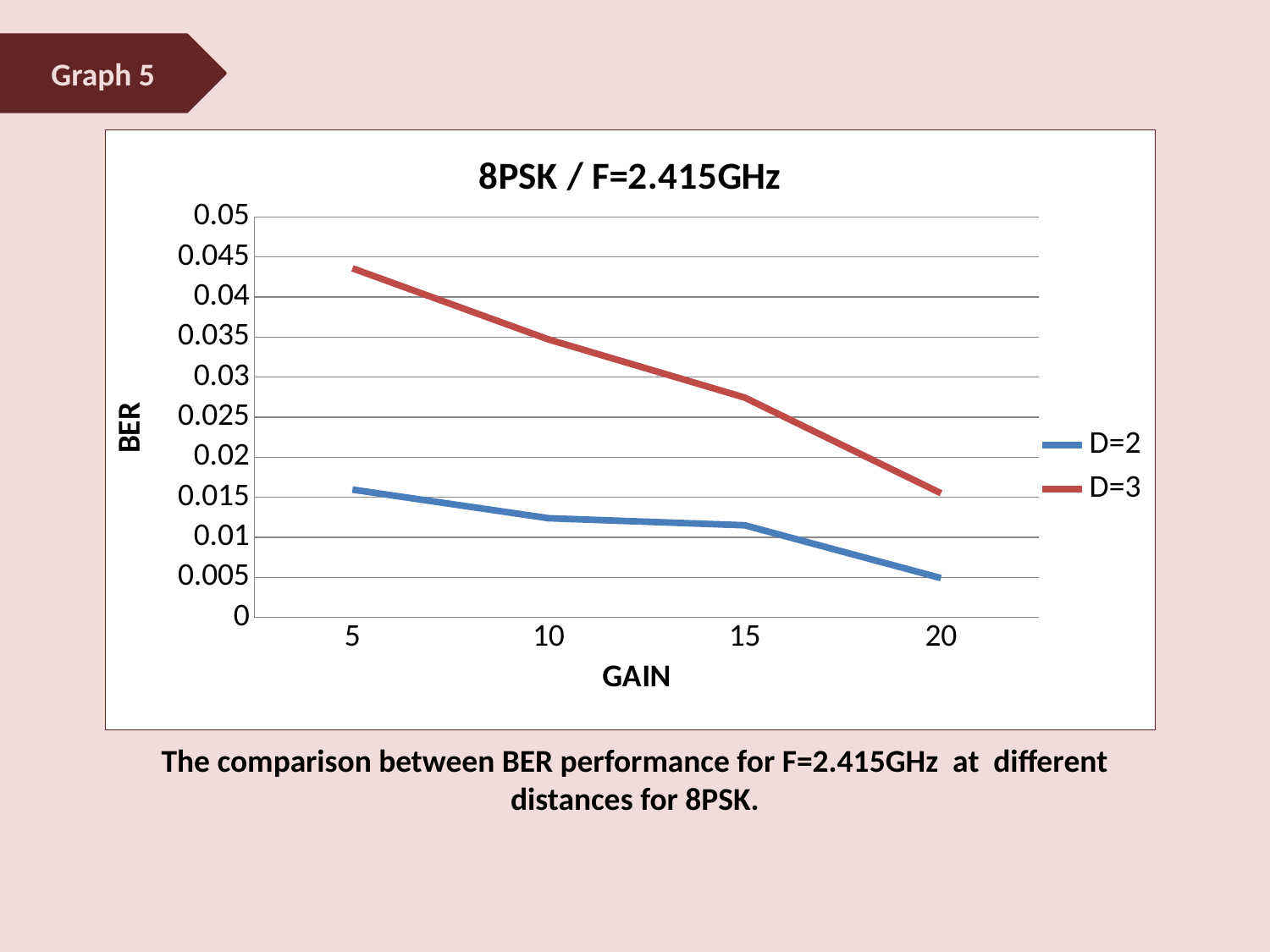
Does the BER for D=3 rise or fall as GAIN increases from 5 to 20? fall How many series does the legend list? 2 Is the BER for D=3 at GAIN 20 greater or less than 0.02? less What kind of chart is shown on the slide? line chart At GAIN 10, which series has the larger BER, D=2 or D=3? D=3 Is the BER for D=2 at GAIN 20 greater or less than 0.01? less At which GAIN value is the BER for D=3 highest? 5 How many GAIN values are plotted along the x axis? 4 Does the BER for D=2 rise or fall as GAIN increases from 5 to 20? fall Is the BER for D=3 at GAIN 5 greater or less than 0.04? greater At which GAIN value is the BER for D=2 lowest? 20 What is the title of the chart? 8PSK / F=2.415GHz